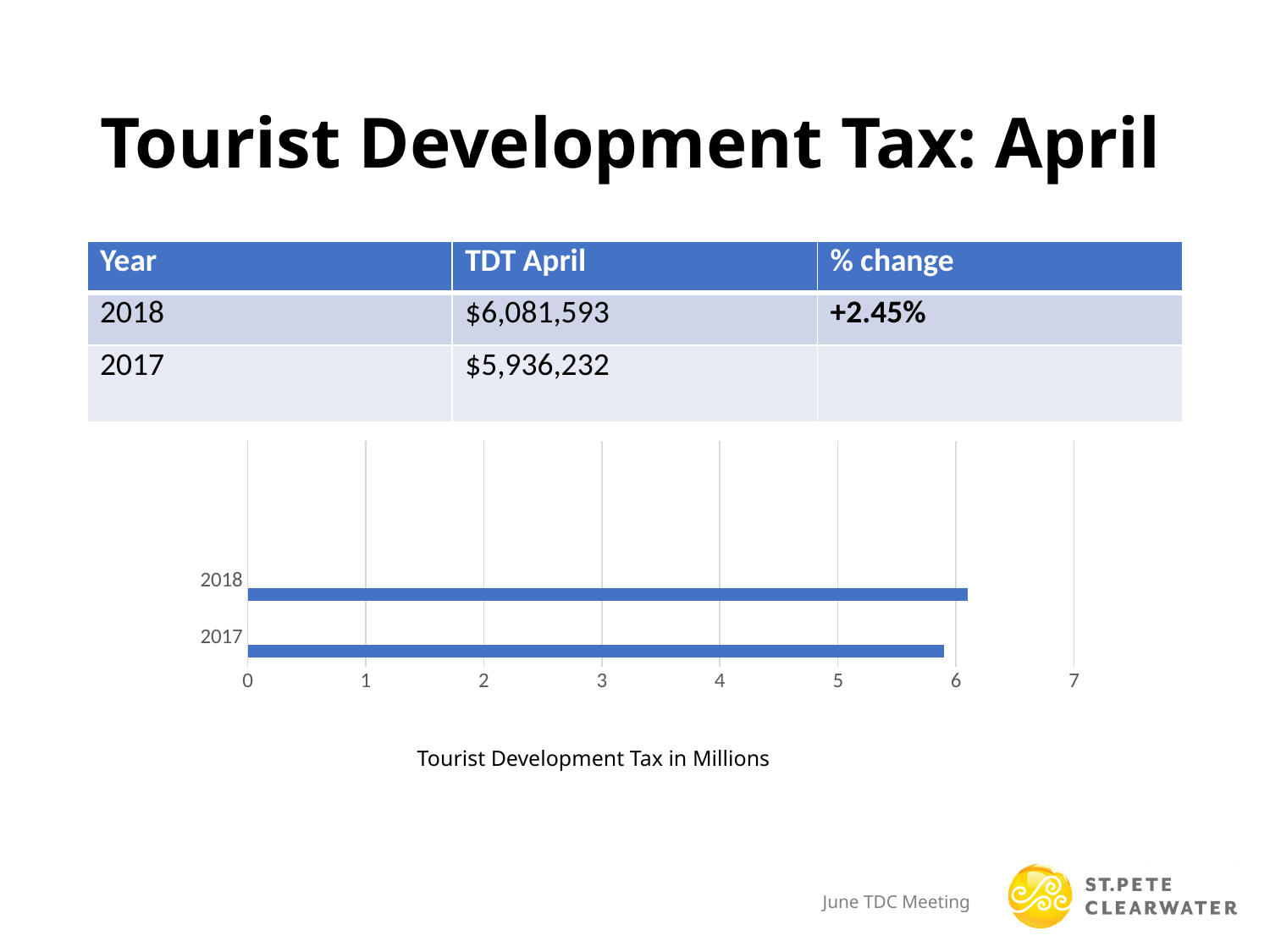
What kind of chart is shown on the slide? bar chart According to the slide, what is the TDT April value for 2017? $5,936,232 How many years (categories) are plotted in the bar chart? 2 Which year has the shorter bar in the chart? 2017 Is the bar for 2017 greater or less than 7 on the axis? less What is the caption shown below the bar chart? Tourist Development Tax in Millions What is the highest tick value shown on the chart's horizontal axis? 7 Which year has the longer bar in the chart? 2018 What is the difference between the 2018 and 2017 TDT April values shown on the slide? $145,361 According to the slide, what is the TDT April value for 2018? $6,081,593 Is the bar for 2018 greater or less than 5 on the axis? greater Is the bar for 2017 greater or less than 4 on the axis? greater